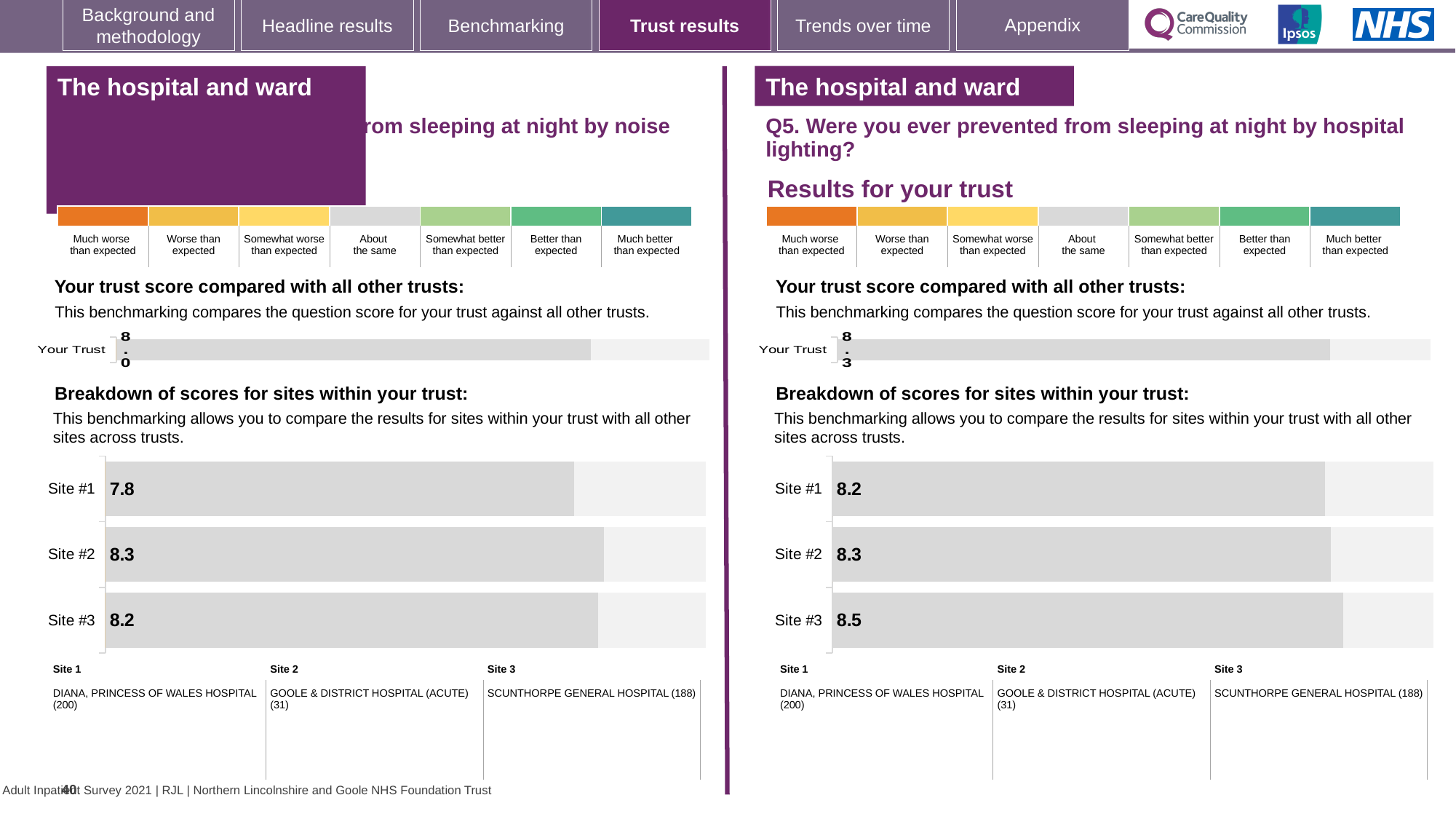
On the right-hand chart (Q5, hospital lighting), how many sites are shown in the breakdown of scores? 3 On the left-hand chart (sleeping at night by noise), what is the score for Site #1? 7.8 On the left-hand chart (sleeping at night by noise), which site has the lowest score? Site #1 On the right-hand chart (Q5, hospital lighting), what is the score for Site #3? 8.5 On the left-hand chart (sleeping at night by noise), what is the difference between the Site #2 and Site #1 scores? 0.5 On the right-hand chart (Q5, hospital lighting), what is the difference between the Site #3 and Site #1 scores? 0.3 On the right-hand chart (Q5, hospital lighting), which site has the highest score? Site #3 On the right-hand 'Your trust score compared with all other trusts' chart, what is the score for Your Trust? 8.3 What type of chart is used for the breakdown of scores for sites within your trust? Bar chart On the left-hand chart (sleeping at night by noise), what is the score for Site #2? 8.3 On the left-hand 'Your trust score compared with all other trusts' chart, what is the score for Your Trust? 8.0 Which is larger: the Site #1 score on the left-hand chart (noise) or the Site #1 score on the right-hand chart (Q5, lighting)? Right-hand chart (Q5, lighting)